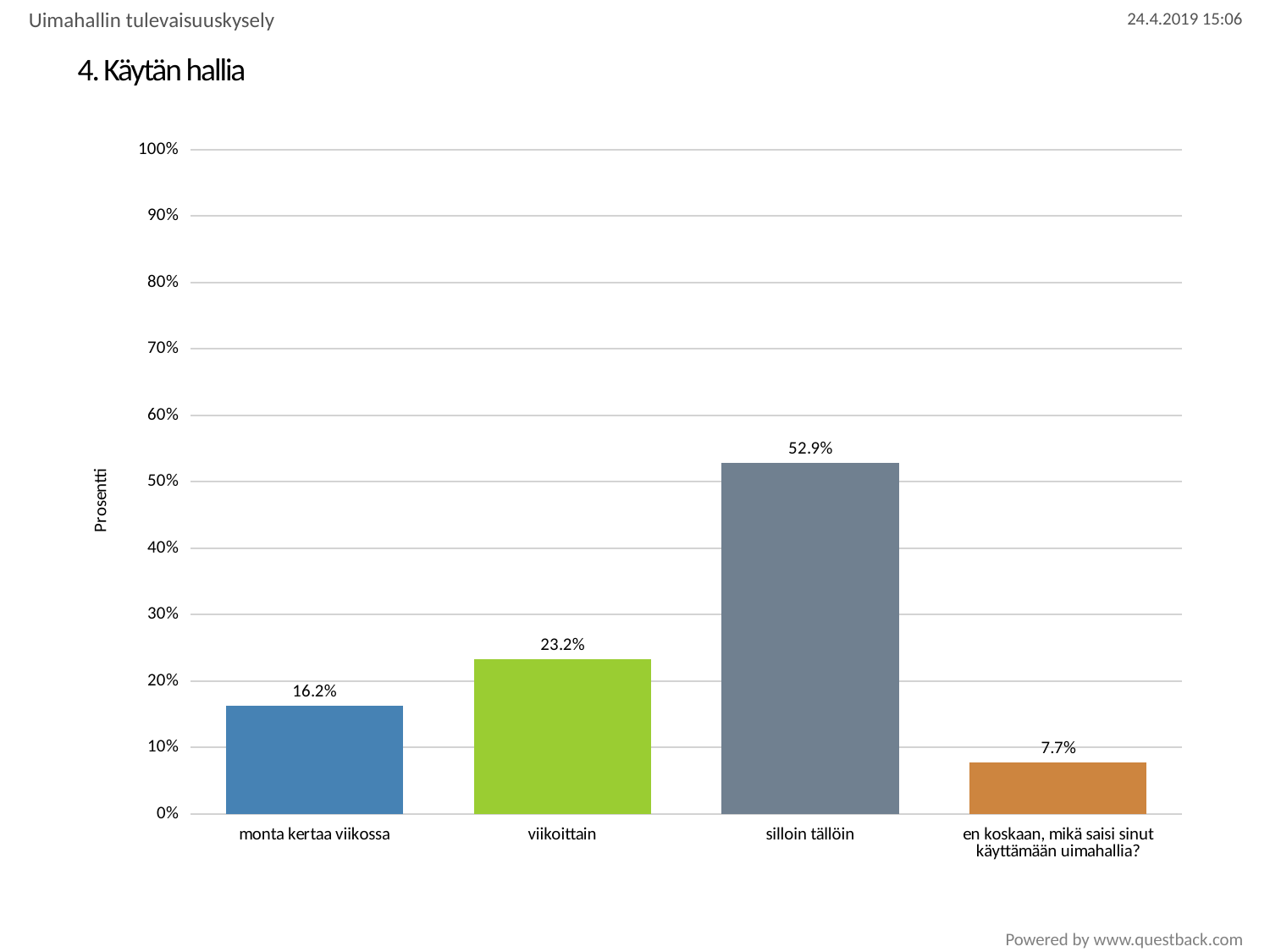
What kind of chart is shown on the slide? bar chart What is the value for "viikoittain"? 23.2% What is the value for "en koskaan, mikä saisi sinut käyttämään uimahallia?"? 7.7% What is the difference between the values for "silloin tällöin" and "viikoittain"? 29.7% What is the value for "silloin tällöin"? 52.9% How many categories are shown on the x axis? 4 Which is larger, the value for "viikoittain" or the value for "monta kertaa viikossa"? viikoittain Is the value for "silloin tällöin" greater or less than 50%? greater What is the value for "monta kertaa viikossa"? 16.2% What is the title of the chart? 4. Käytän hallia Which category has the lowest value? en koskaan, mikä saisi sinut käyttämään uimahallia? Which category has the highest value? silloin tällöin